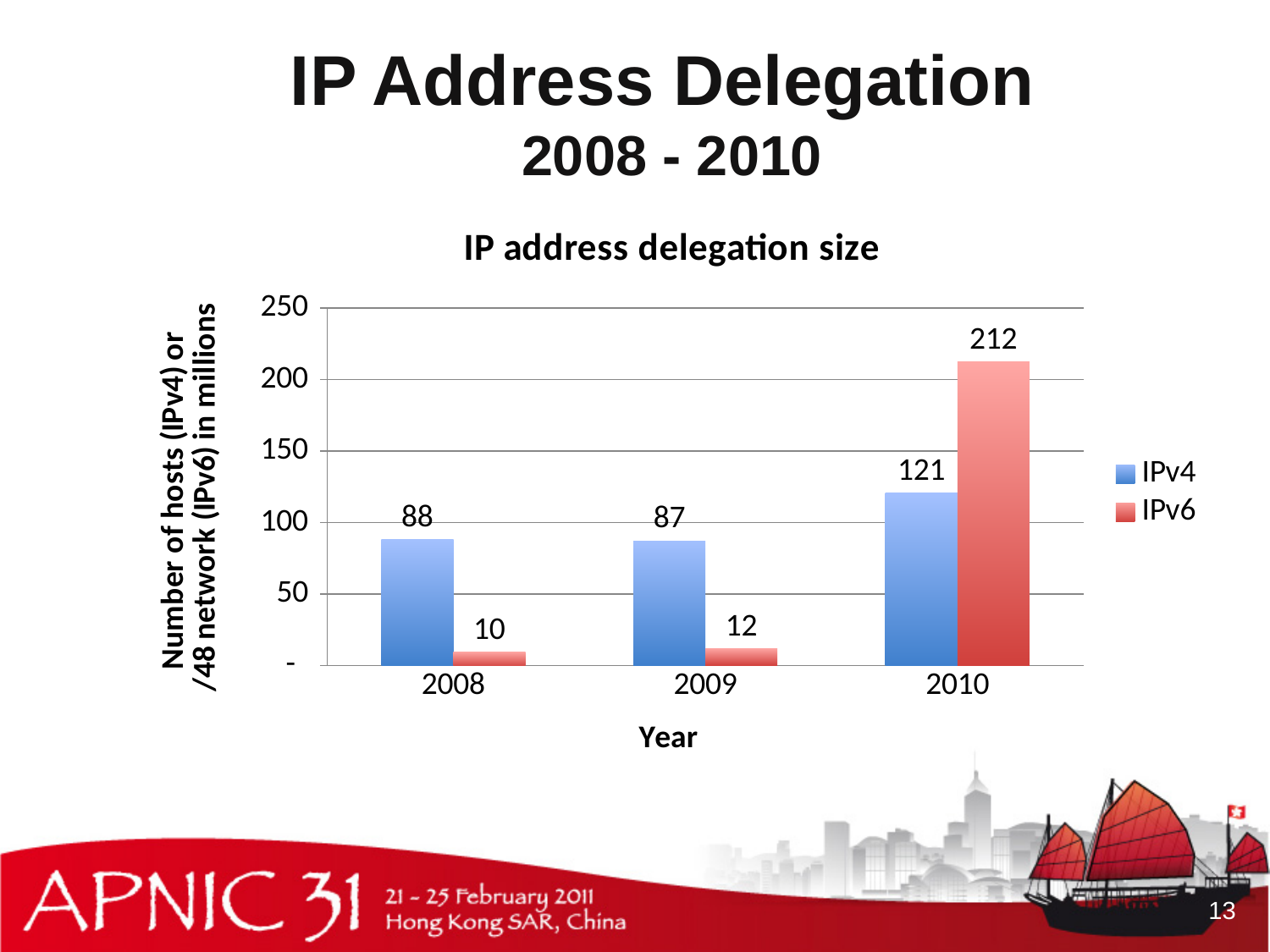
What is the IPv4 value for 2010? 121 What is the difference between the IPv6 and IPv4 values in 2010? 91 What is the IPv4 value for 2008? 88 What is the IPv6 value for 2010? 212 What is the title of the chart? IP address delegation size What kind of chart is shown on the slide? Bar chart Which is larger in 2009, the IPv4 value or the IPv6 value? IPv4 How many series does the legend list? 2 Which year has the lowest IPv6 value? 2008 How many years are shown on the x axis? 3 Which year has the highest IPv6 value? 2010 What is the IPv6 value for 2009? 12